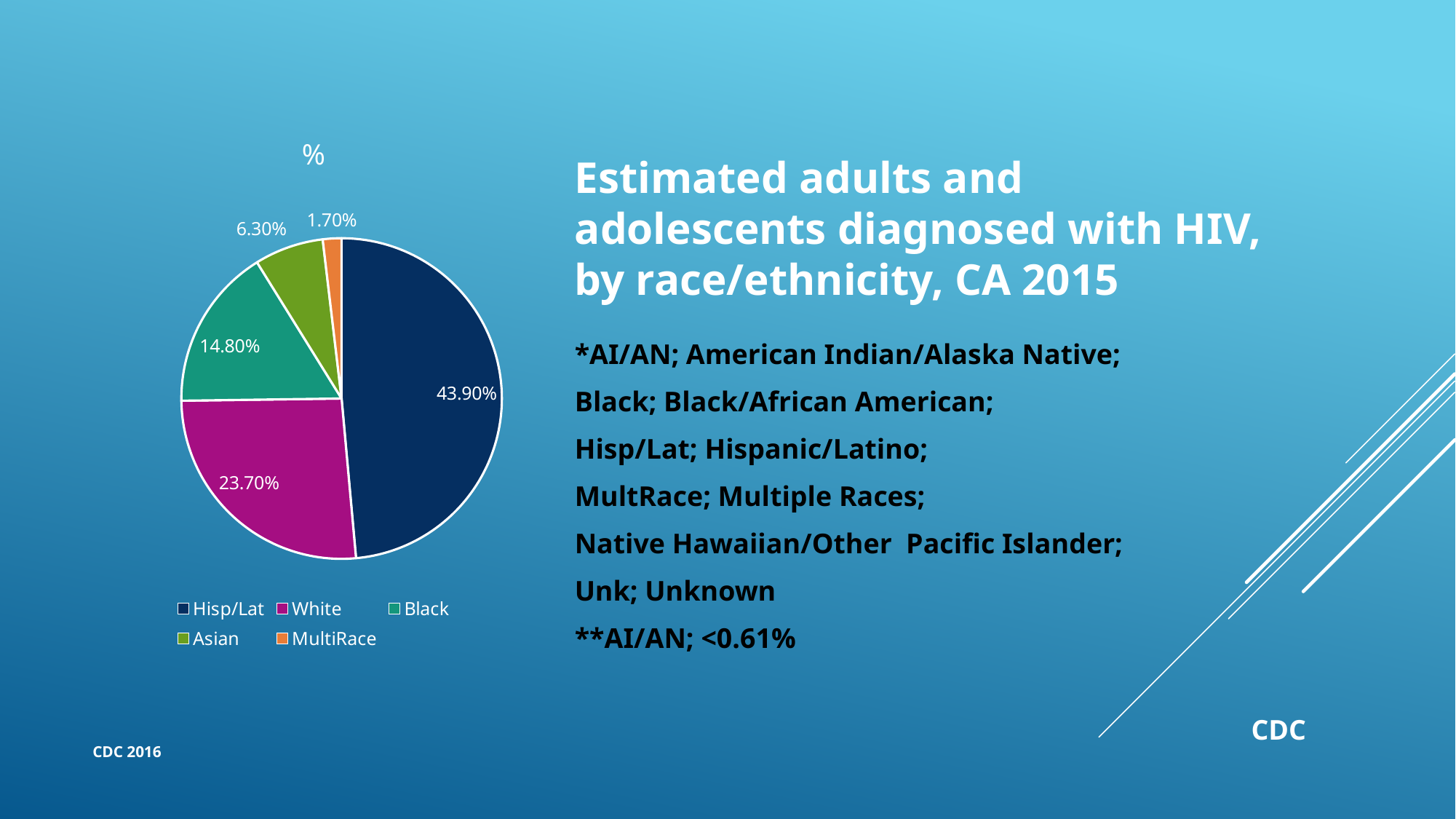
What percentage does the White slice show? 23.70% What percentage does the Asian slice show? 6.30% What kind of chart is shown on the slide? pie chart What percentage does the MultiRace slice show? 1.70% Which category has the smallest slice of the pie? MultiRace What is the difference between the Hisp/Lat and White percentages? 20.20% What is the title shown above the pie chart? % Which is larger, the Black slice or the Asian slice? Black How many categories does the legend list? 5 What percentage does the Hisp/Lat slice show? 43.90% What percentage does the Black slice show? 14.80% Which category has the largest slice of the pie? Hisp/Lat